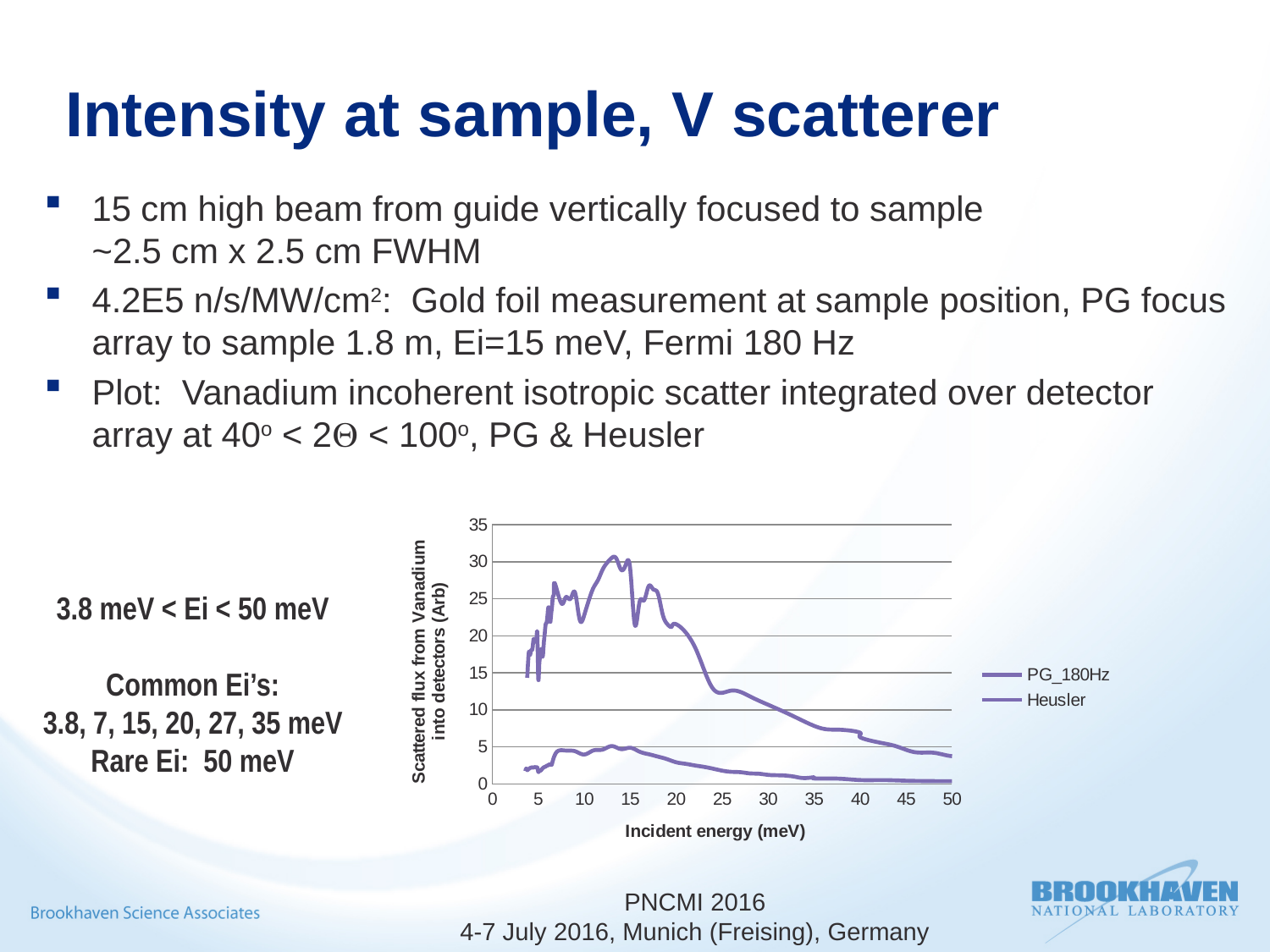
Is the value of the upper curve at 50 meV greater or less than 5? less Does the upper curve rise or fall as incident energy increases from 20 meV to 50 meV? fall What is the maximum value shown on the chart's y-axis? 35 How many series does the chart legend list? 2 Is the value of the upper curve at 10 meV greater or less than 20? greater Is the value of the lower curve at 50 meV greater or less than 5? less What kind of chart is shown on the slide? line chart What is the x-axis title of the chart? Incident energy (meV) What are the two series named in the chart legend? PG_180Hz and Heusler